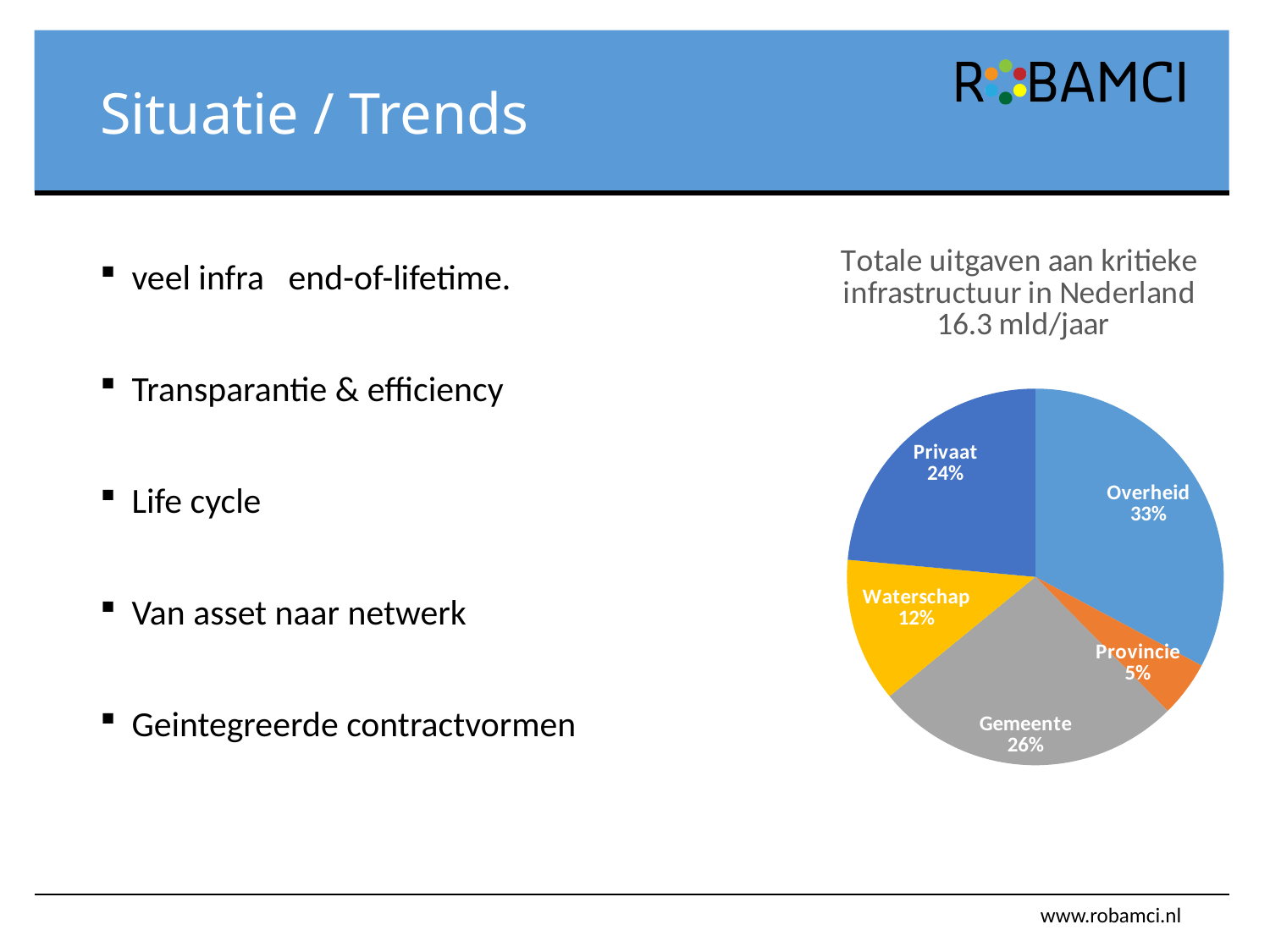
What percentage is shown for Gemeente in the pie chart? 26% What type of chart is shown on the slide? Pie chart How many categories are shown in the pie chart? 5 What share of the pie chart does Overheid represent? 33% What is the difference in percentage points between Gemeente and Privaat? 2 Which category has the smallest share of the pie chart? Provincie What percentage is shown for Privaat in the pie chart? 24% What is the difference in percentage points between Overheid and Provincie? 28 Which has a larger share, Waterschap or Privaat? Privaat Which category has the largest share of the pie chart? Overheid What percentage is shown for Waterschap in the pie chart? 12% What is the title of the pie chart? Totale uitgaven aan kritieke infrastructuur in Nederland 16.3 mld/jaar